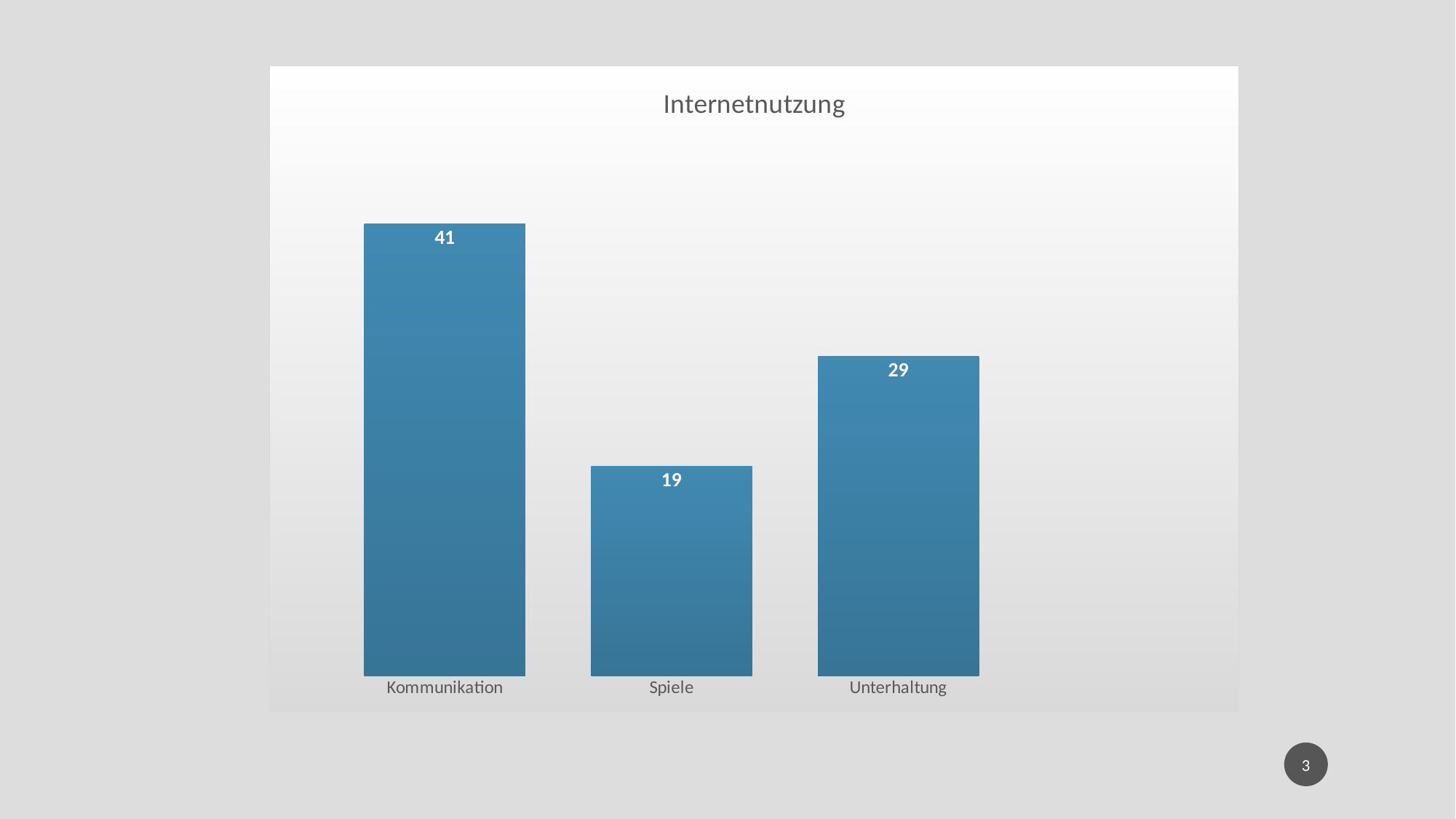
Which is larger, the value for Unterhaltung or the value for Spiele? Unterhaltung What is the value for Spiele? 19 What is the title of the chart? Internetnutzung What is the difference between the values for Kommunikation and Spiele? 22 What is the difference between the values for Unterhaltung and Spiele? 10 Which category has the highest value? Kommunikation What is the value for Unterhaltung? 29 What is the value for Kommunikation? 41 What kind of chart is shown on the slide? Bar chart Which category has the lowest value? Spiele What is the total of the three values shown in the chart? 89 How many categories are shown in the chart? 3